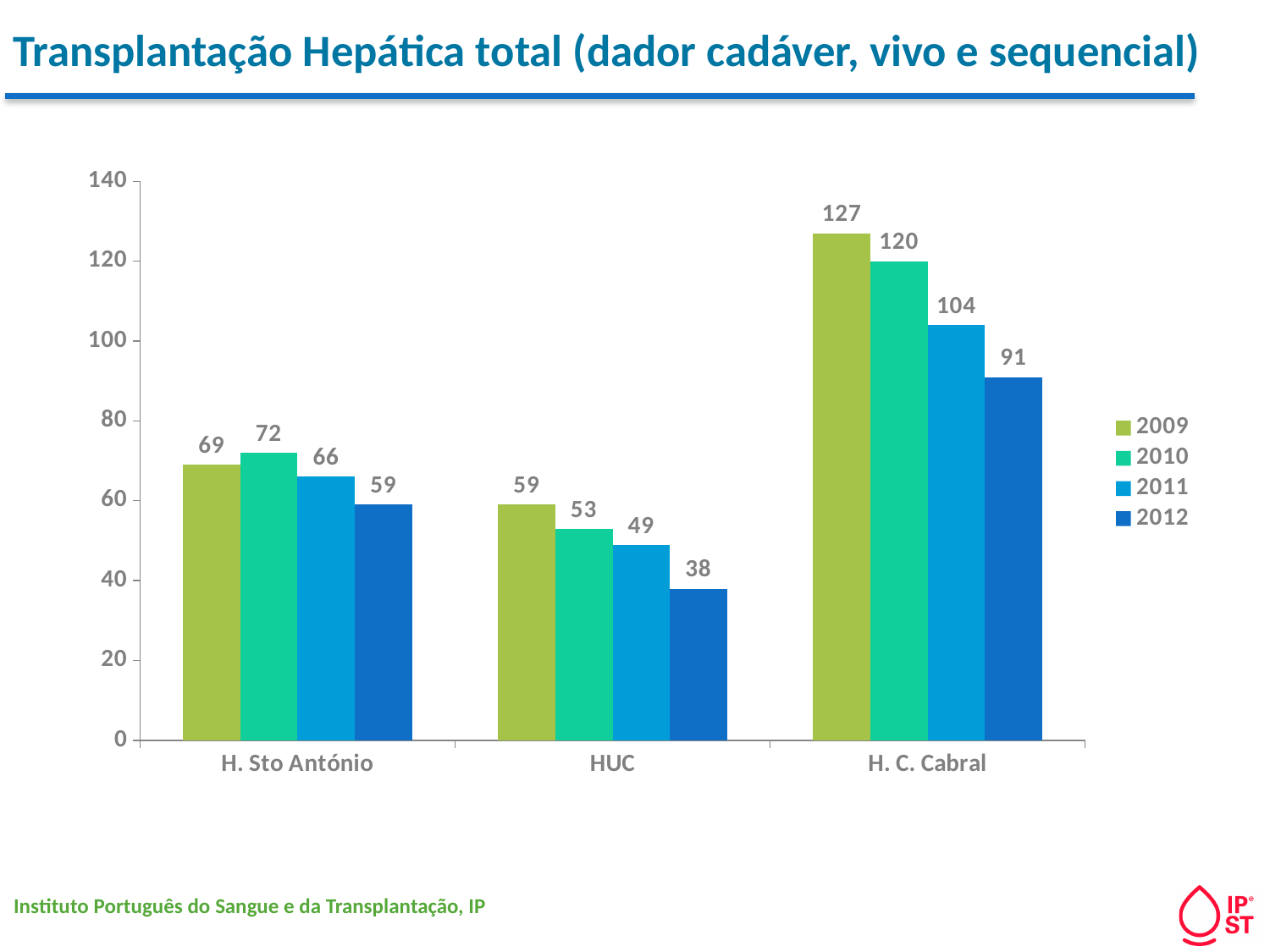
Which hospital has the lowest value in 2012? HUC What is the value for H. C. Cabral in 2009? 127 What is the value for HUC in 2012? 38 Which hospital has the highest value in 2011? H. C. Cabral Do the values for HUC rise or fall from 2009 to 2012? fall What kind of chart is shown on the slide? bar chart How many hospitals are shown on the x axis? 3 What is the value for H. Sto António in 2010? 72 How many series does the legend list? 4 Which is larger: the 2010 value for H. Sto António or the 2010 value for HUC? H. Sto António Is the value for H. C. Cabral in 2010 greater or less than 100? greater What is the difference between the 2009 and 2012 values for H. C. Cabral? 36